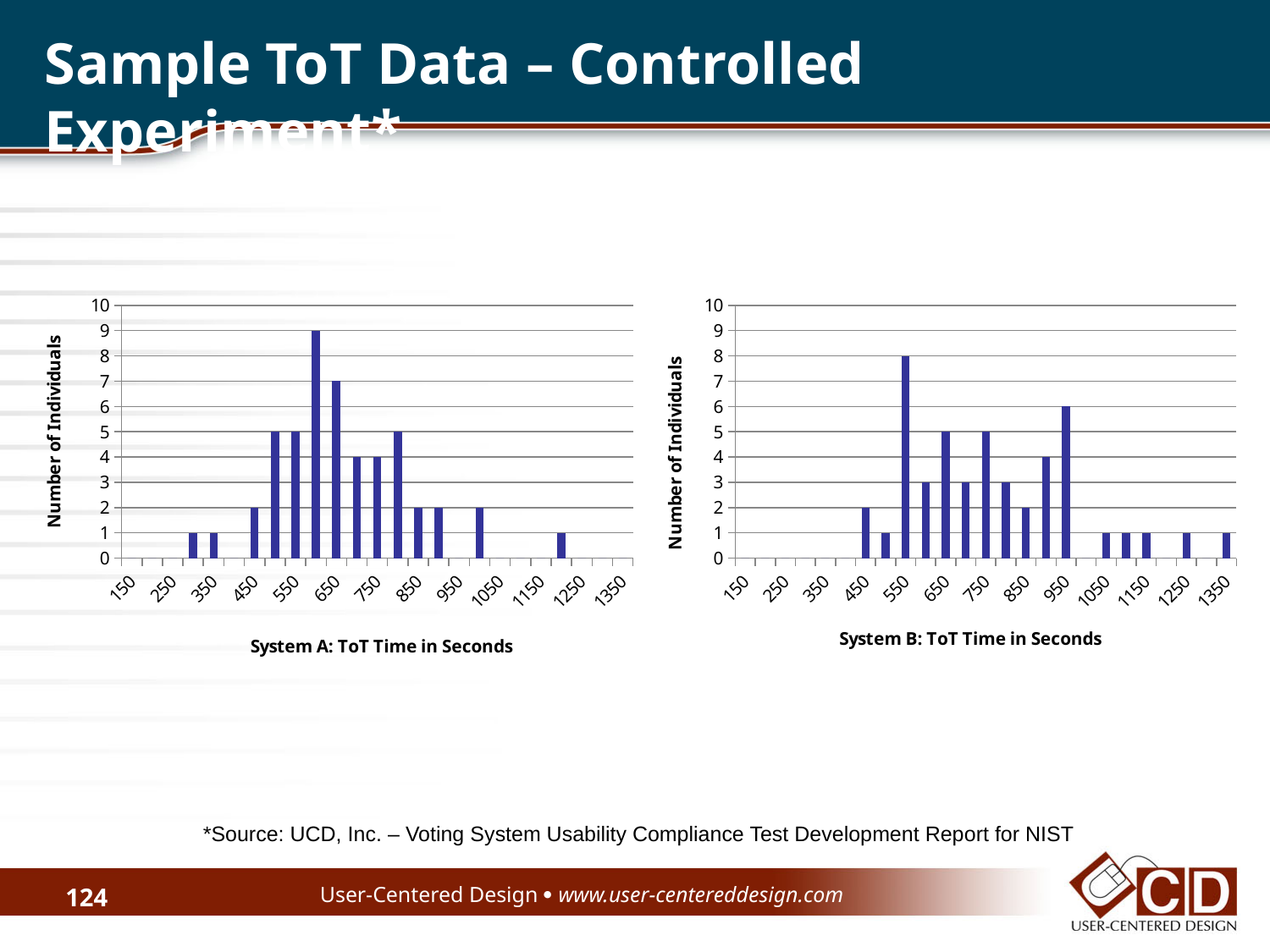
Which chart has the taller peak bar, System A or System B? System A In the System A: ToT Time in Seconds chart, how many individuals are shown at 450 seconds? 2 In the System B: ToT Time in Seconds chart, how many individuals are shown at 550 seconds? 8 In the System A: ToT Time in Seconds chart, how many individuals are shown at 650 seconds? 7 In the System A: ToT Time in Seconds chart, is the value at 350 seconds greater or less than 5? less What is the label on the vertical axis of both charts? Number of Individuals What is the maximum value shown on the vertical axis of the System B chart? 10 In the System B: ToT Time in Seconds chart, is the value at 550 seconds greater or less than 5? greater What type of chart is used for System A: ToT Time in Seconds? bar chart In the System B: ToT Time in Seconds chart, how many individuals are shown at 950 seconds? 6 In the System A: ToT Time in Seconds chart, what is the highest number of individuals shown for any bar? 9 In the System B: ToT Time in Seconds chart, what is the highest number of individuals shown for any bar? 8